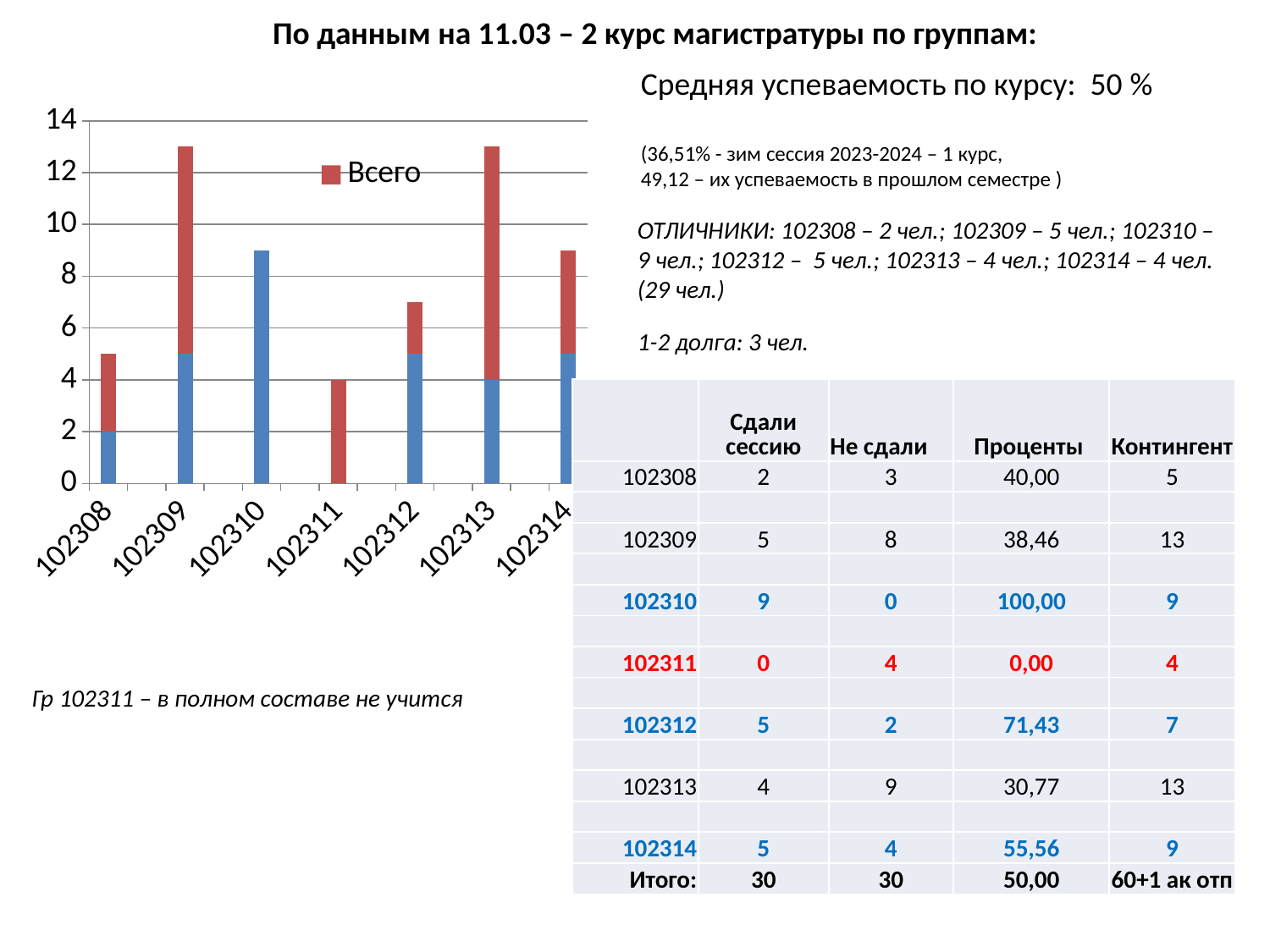
Is the total bar for group 102312 greater or less than 8? less Which group's bar has no red segment at all? 102310 What is the value of the blue segment for group 102308? 2 Which group has the taller total bar, 102310 or 102312? 102310 What is the name of the series shown in the chart's legend? Всего What kind of chart is shown on the left of the slide? bar chart Is the total bar for group 102309 greater or less than 12? greater What is the total height of the bar for group 102311? 4 How many groups (categories) are shown on the x axis of the chart? 7 How many series does the chart's legend list? 1 Which group has the shortest total bar in the chart? 102311 What is the value of the blue segment for group 102313? 4